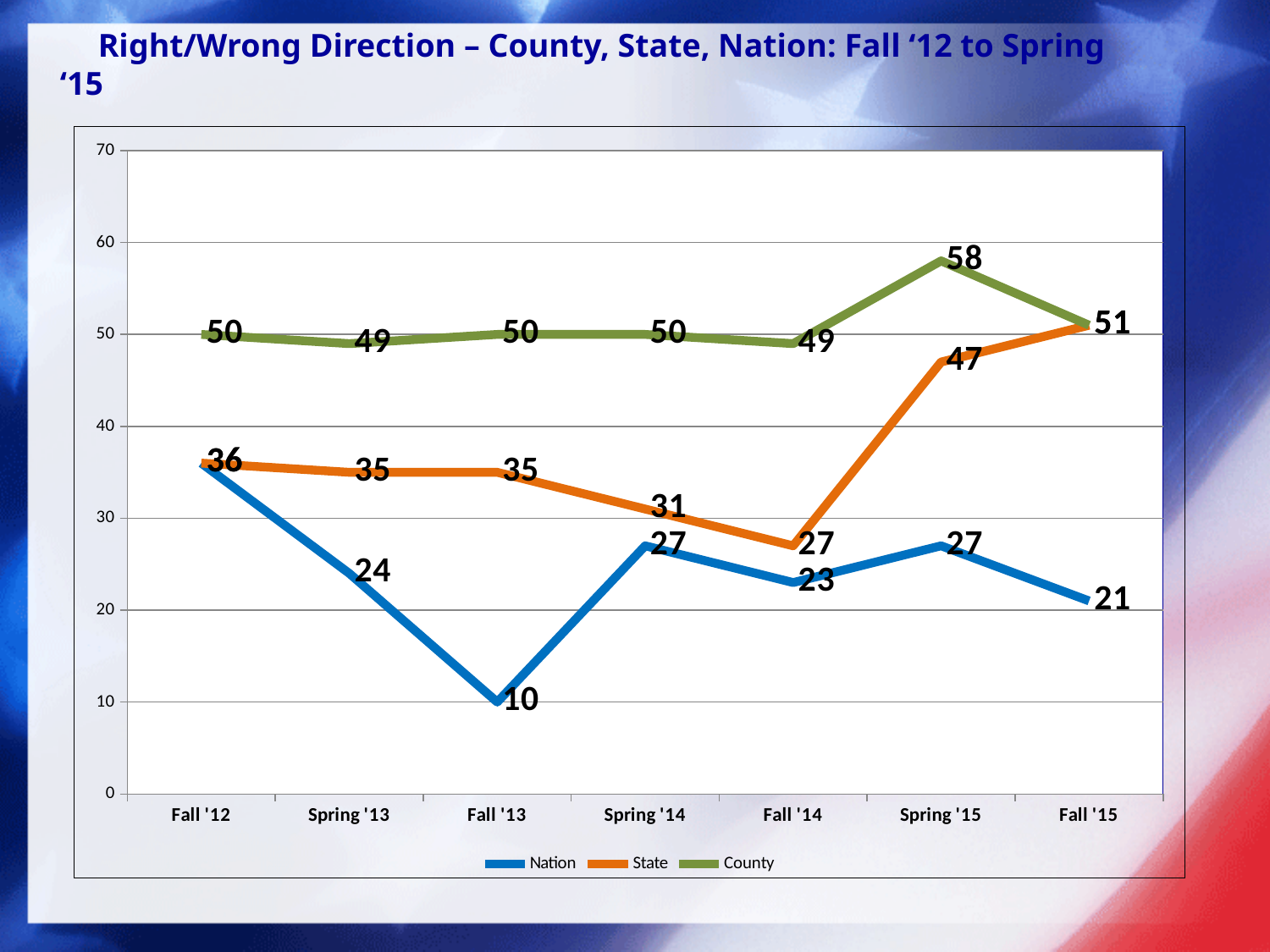
What is the Nation value for Fall '13? 10 At which time point is the County series highest? Spring '15 What is the difference between the County and State values in Spring '15? 11 How many time points are shown along the x axis? 7 Does the State series rise or fall from Fall '12 to Fall '14? Fall At which time point is the Nation series lowest? Fall '13 In Fall '14, which is larger, the State value or the Nation value? State How many series does the legend list? 3 What is the State value for Spring '14? 31 What kind of chart is shown on the slide? Line chart What is the County value for Spring '15? 58 What colour is the County line in the legend? Green